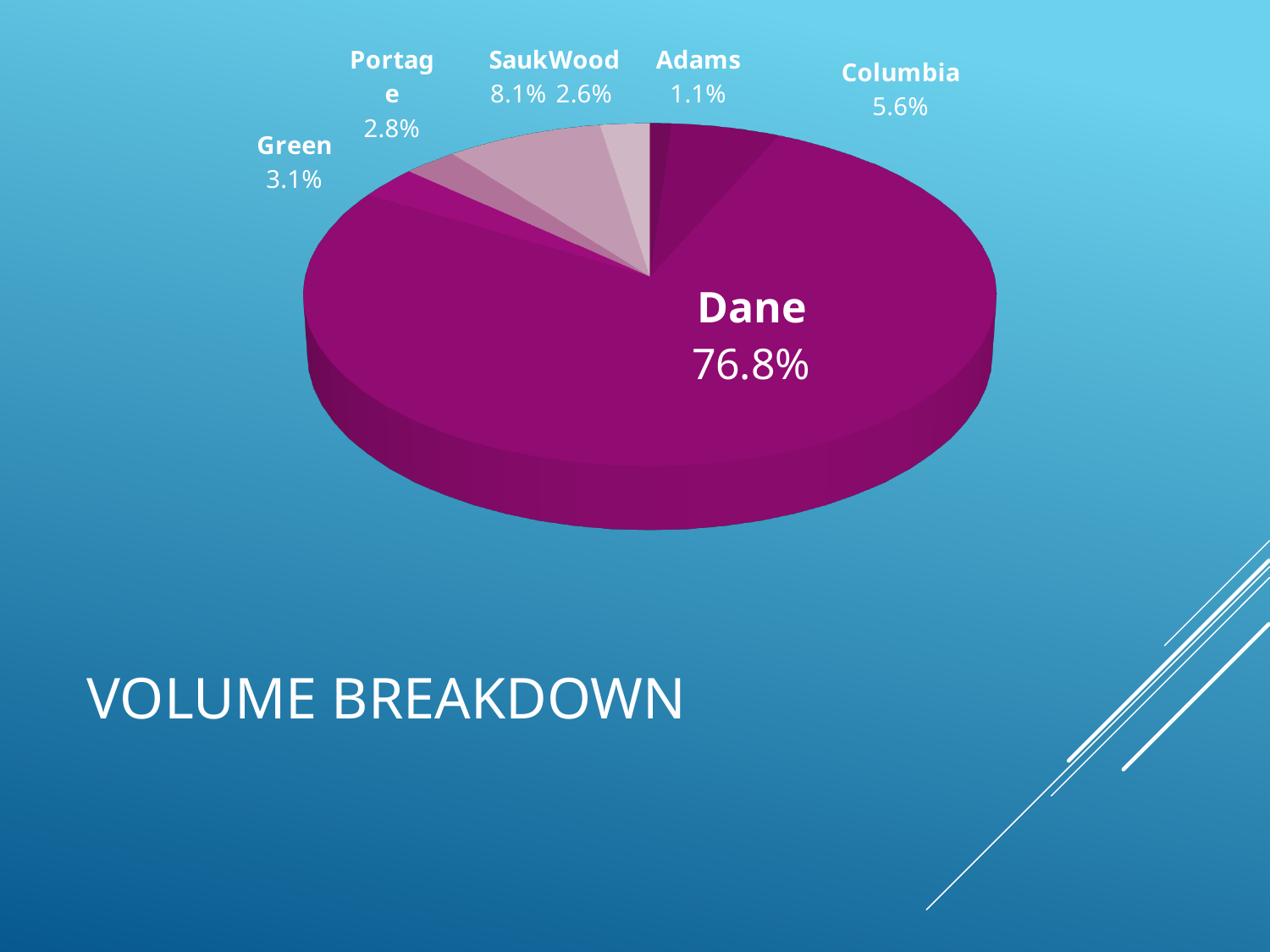
What kind of chart is shown on the slide? Pie chart What share of the pie does Dane account for? 76.8% Which category has the largest slice of the pie? Dane Which category has the smallest slice of the pie? Adams What percentage is shown for Sauk? 8.1% What percentage is shown for Adams? 1.1% What percentage is shown for Columbia? 5.6% What percentage is shown for Green? 3.1% Which is larger, the share for Green or the share for Portage? Green What is the title of the slide containing the chart? VOLUME BREAKDOWN How many categories are shown in the pie chart? 7 What is the difference in percentage points between Sauk and Columbia? 2.5